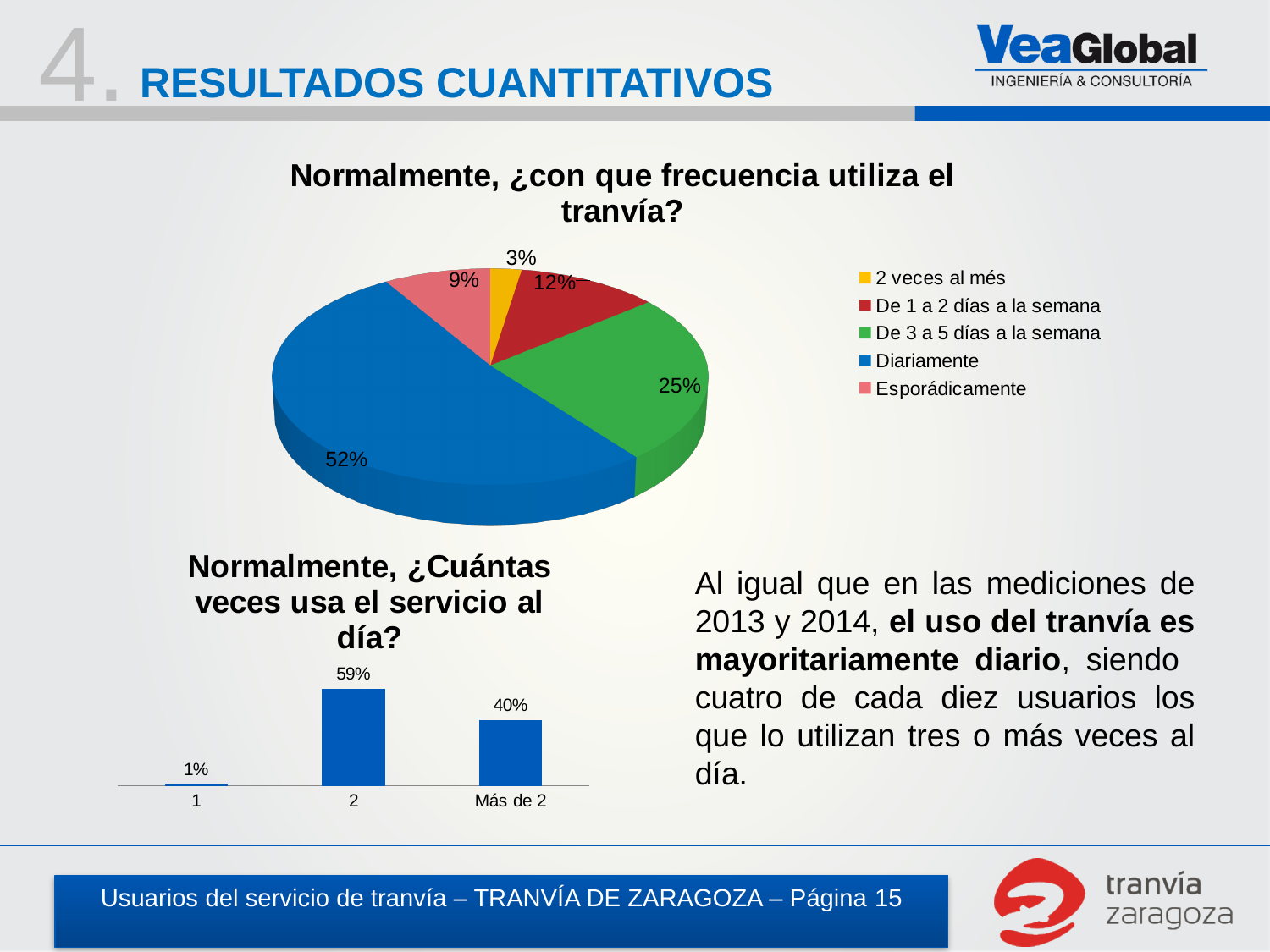
In the bar chart 'Normalmente, ¿Cuántas veces usa el servicio al día?', what is the difference between '2' and 'Más de 2'? 19% In the pie chart 'Normalmente, ¿con que frecuencia utiliza el tranvía?', what share corresponds to 'Diariamente'? 52% In the pie chart 'Normalmente, ¿con que frecuencia utiliza el tranvía?', which category has the smallest share? 2 veces al més In the pie chart 'Normalmente, ¿con que frecuencia utiliza el tranvía?', what is the difference between 'Diariamente' and 'De 3 a 5 días a la semana'? 27% In the pie chart 'Normalmente, ¿con que frecuencia utiliza el tranvía?', what colour is the 'De 1 a 2 días a la semana' slice? Red In the bar chart 'Normalmente, ¿Cuántas veces usa el servicio al día?', which category has the lowest value? 1 In the pie chart 'Normalmente, ¿con que frecuencia utiliza el tranvía?', which category has the largest share? Diariamente In the bar chart 'Normalmente, ¿Cuántas veces usa el servicio al día?', what is the value for '2'? 59% In the pie chart 'Normalmente, ¿con que frecuencia utiliza el tranvía?', what share corresponds to 'De 3 a 5 días a la semana'? 25% In the pie chart 'Normalmente, ¿con que frecuencia utiliza el tranvía?', what share corresponds to 'Esporádicamente'? 9% How many categories does the legend of the pie chart 'Normalmente, ¿con que frecuencia utiliza el tranvía?' list? 5 What kind of chart is 'Normalmente, ¿Cuántas veces usa el servicio al día?'? Bar chart